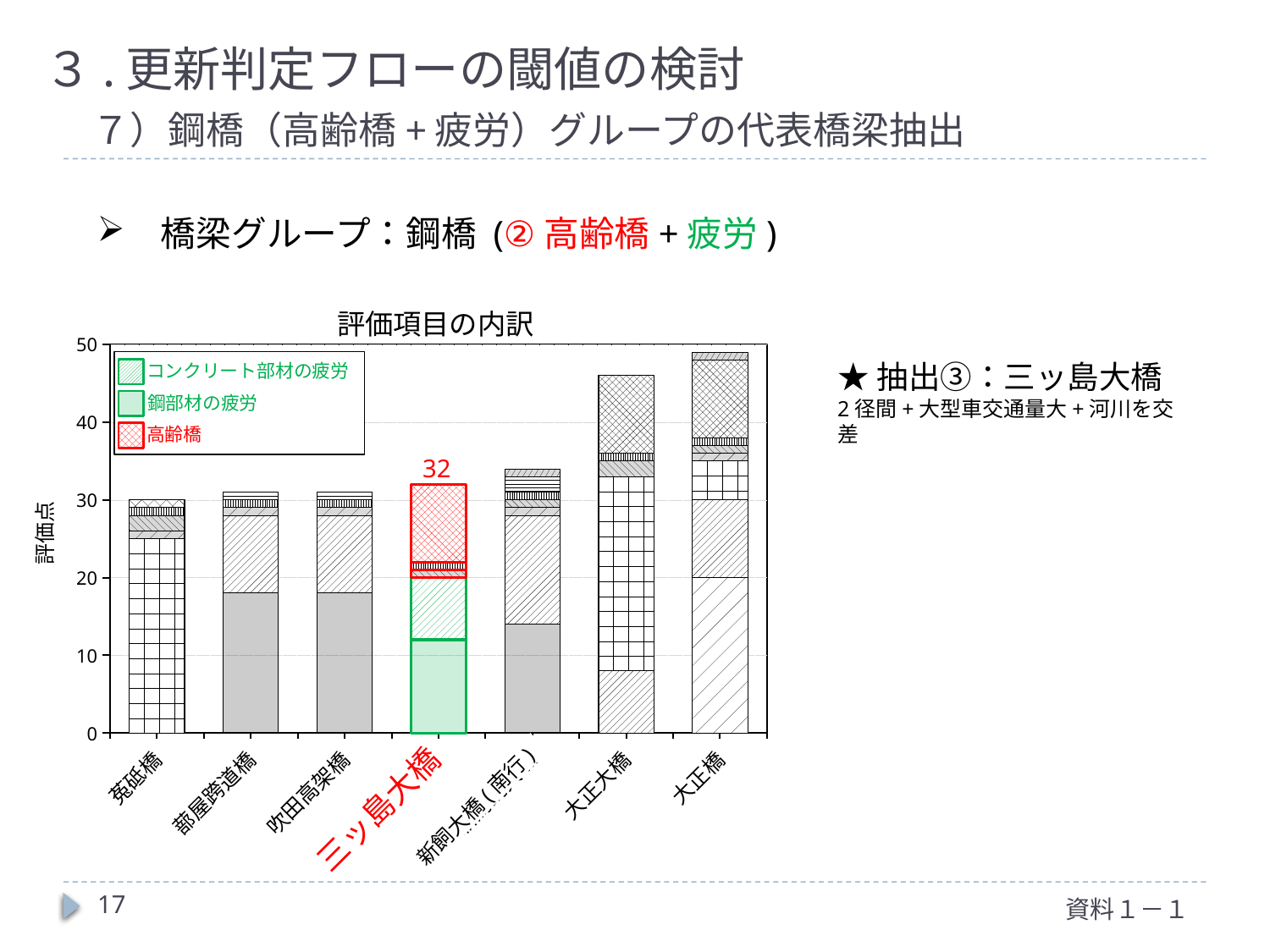
What is the total value printed for 三ッ島大橋? 32 Is the total for 新飼大橋(南行) greater or less than 30? greater Which bridge has the highest total bar? 大正橋 How many entries does the legend list? 3 Is the total for 大正大橋 greater or less than 40? greater What kind of chart is shown? stacked bar chart How many bridges are shown on the x axis? 7 Which bar is taller, 大正大橋 or 三ッ島大橋? 大正大橋 Which bar is taller, 大正橋 or 菟砥橋? 大正橋 Is the total for 菟砥橋 greater or less than 40? less What is the title of the chart? 評価項目の内訳